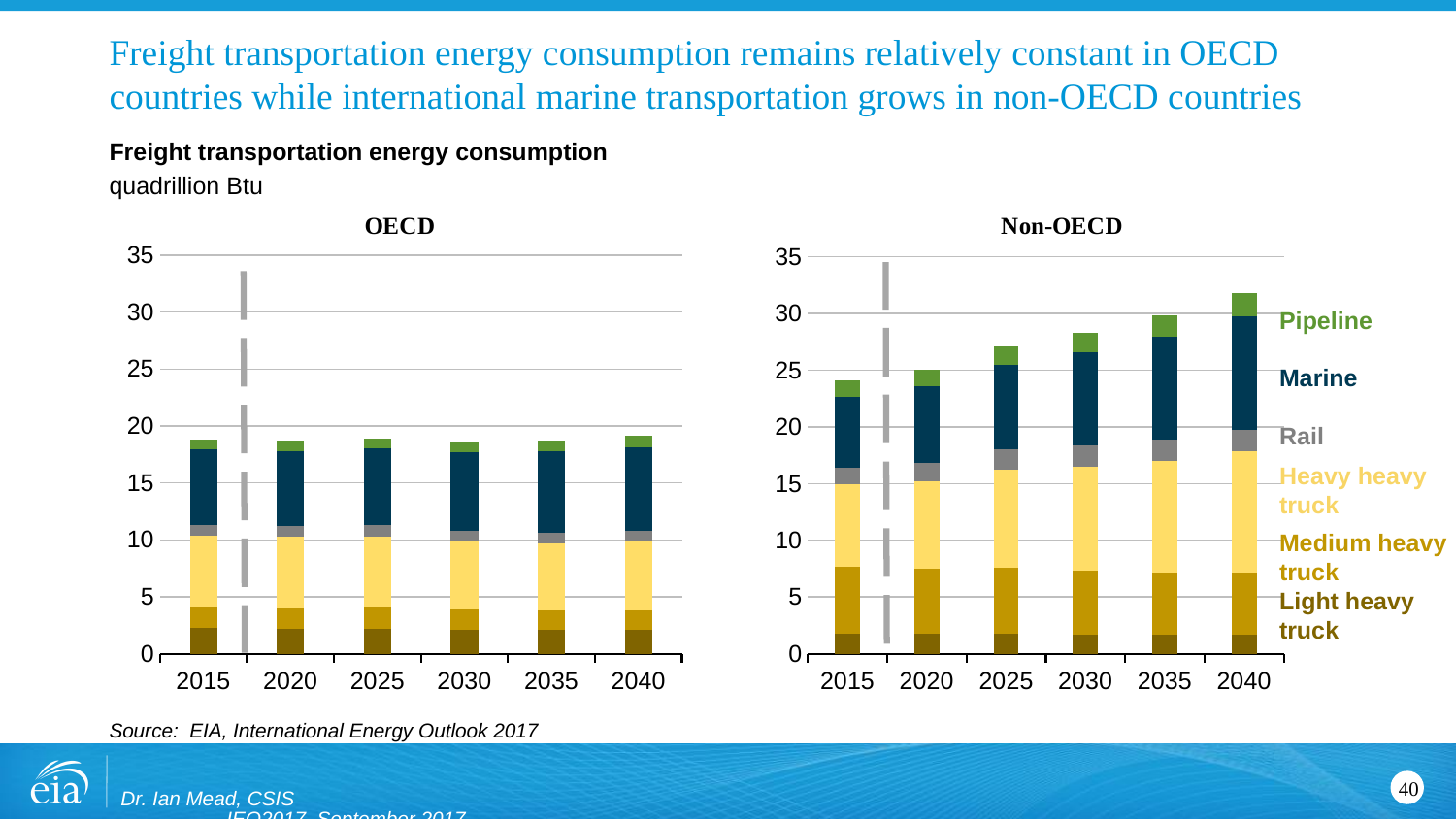
In the Non-OECD chart, do total values rise or fall from 2015 to 2040? rise In the Non-OECD chart, is the total value for 2040 greater or less than 30? greater In the Non-OECD chart, is the total value for 2015 greater or less than 25? less How many series does the legend list for the freight transportation energy consumption charts? 6 Which is larger in 2040: the total for the OECD chart or the total for the Non-OECD chart? Non-OECD What unit is used for the values in the freight transportation energy consumption charts? quadrillion Btu In the OECD chart, is the total value for 2015 greater or less than 20? less In the Non-OECD chart, which year has the highest total freight transportation energy consumption? 2040 How many years are shown on the x axis of the Non-OECD chart? 6 In the Non-OECD chart, which year has the lowest total freight transportation energy consumption? 2015 What kind of chart is the OECD chart? stacked bar chart Which series is shown in dark blue in the charts? Marine